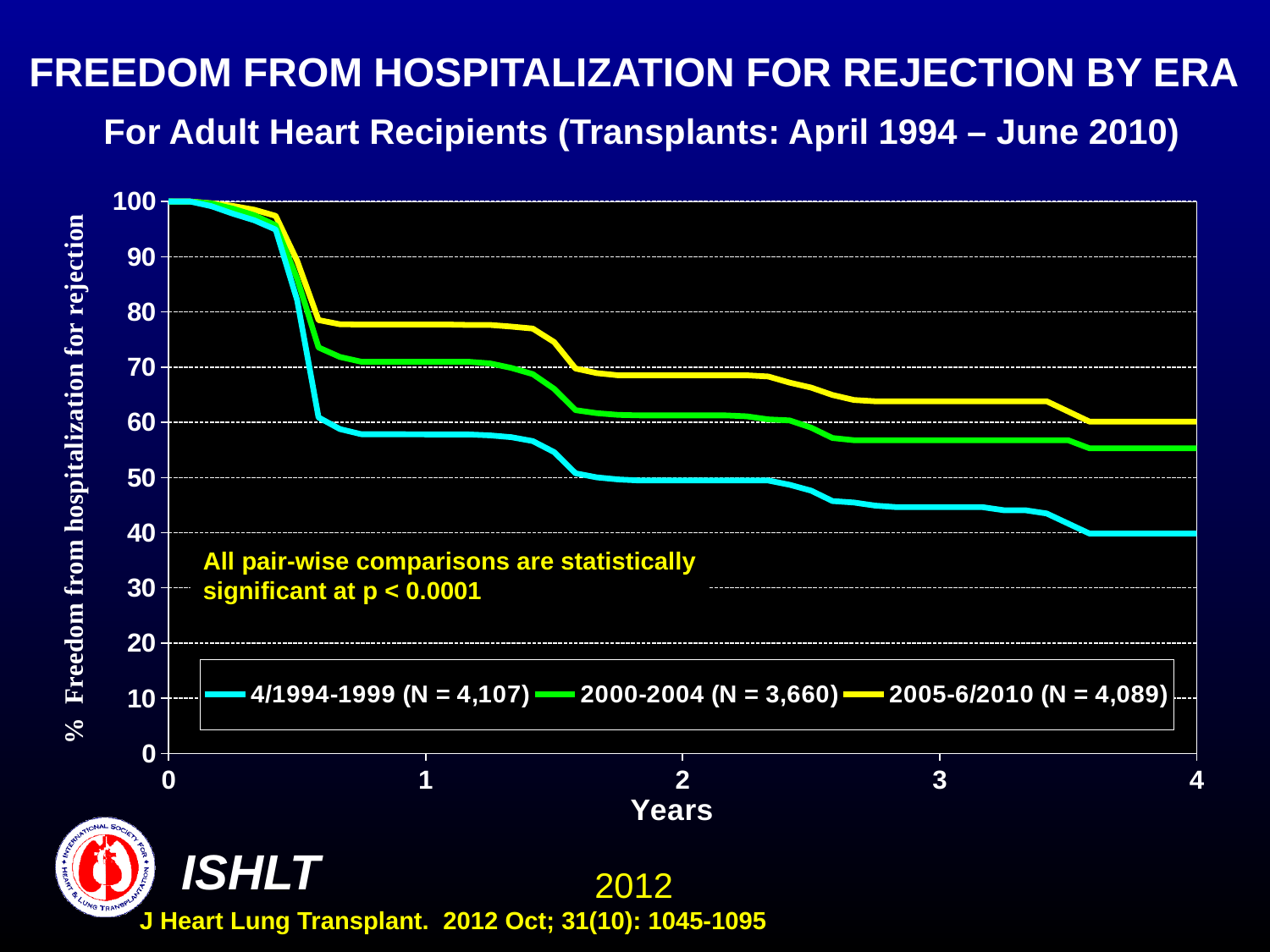
What kind of chart is shown on the slide? line chart At 2 years, which series has the larger value: 2005-6/2010 or 4/1994-1999? 2005-6/2010 Is the value for the 2005-6/2010 series at 3 years greater or less than 60? greater According to the legend, what is N for the 2000-2004 series? 3,660 Is the value for the 4/1994-1999 series at 1 year greater or less than 50? greater Do the values for the 4/1994-1999 series rise or fall as years increase? fall Is the value for the 2000-2004 series at 4 years greater or less than 60? less Which series has the lowest value at 4 years? 4/1994-1999 (N = 4,107) What is the label of the x axis? Years How many series does the legend list? 3 Which series has the highest value at 4 years? 2005-6/2010 (N = 4,089)